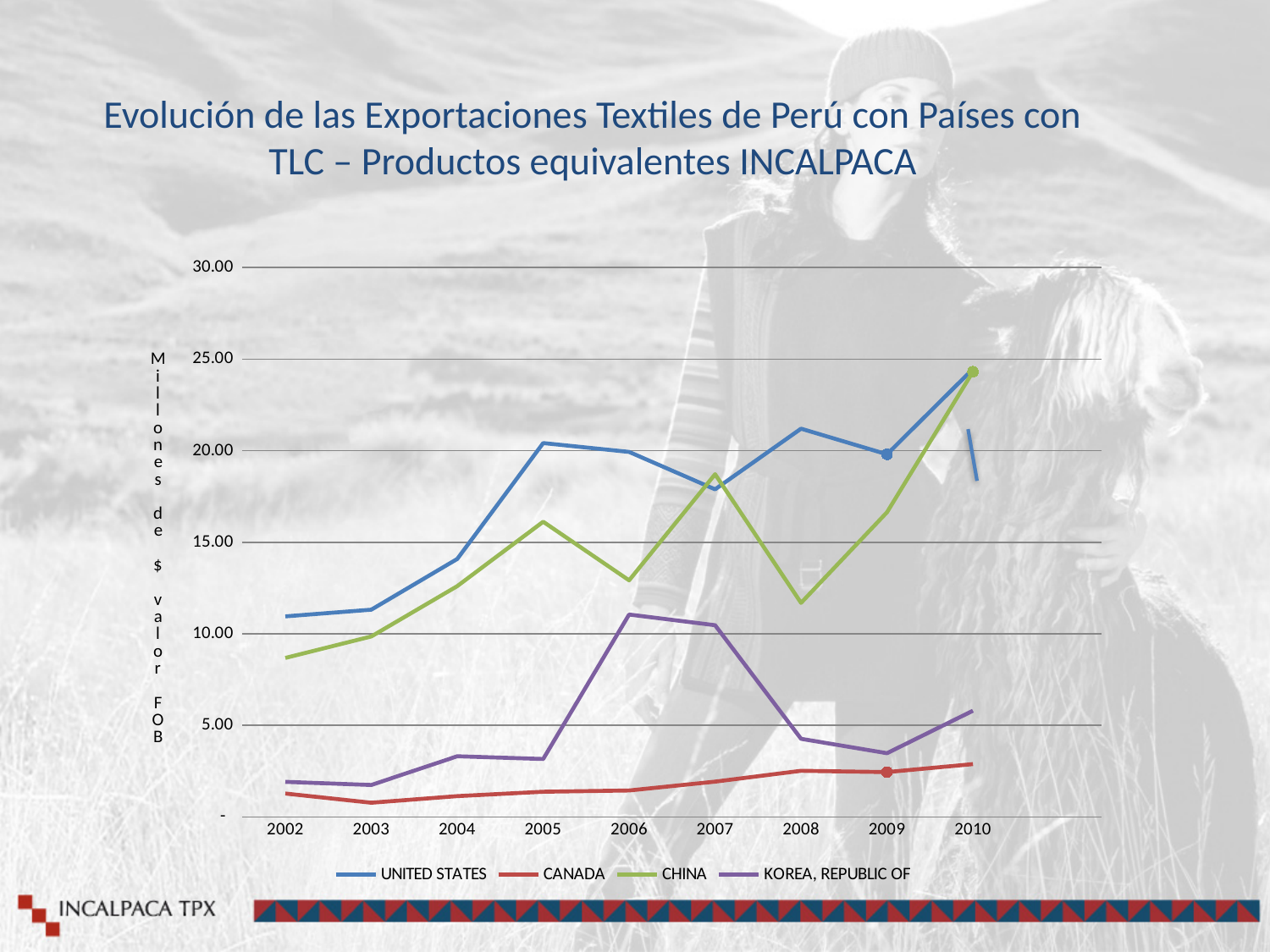
Which colour is used for the CHINA line? green Which series has the lowest value in 2010? CANADA In 2006, which series has a higher value, UNITED STATES or CHINA? UNITED STATES Is the value for CANADA in 2010 greater or less than 5.00? less Does the CANADA line generally rise or fall from 2002 to 2010? rise Is the value for KOREA, REPUBLIC OF in 2006 greater or less than 10.00? greater How many series does the legend list? 4 Is the value for CHINA in 2008 greater or less than 15.00? less How many years are shown along the x axis? 9 Which series has the highest value in 2006? UNITED STATES What kind of chart is shown on the slide? line chart